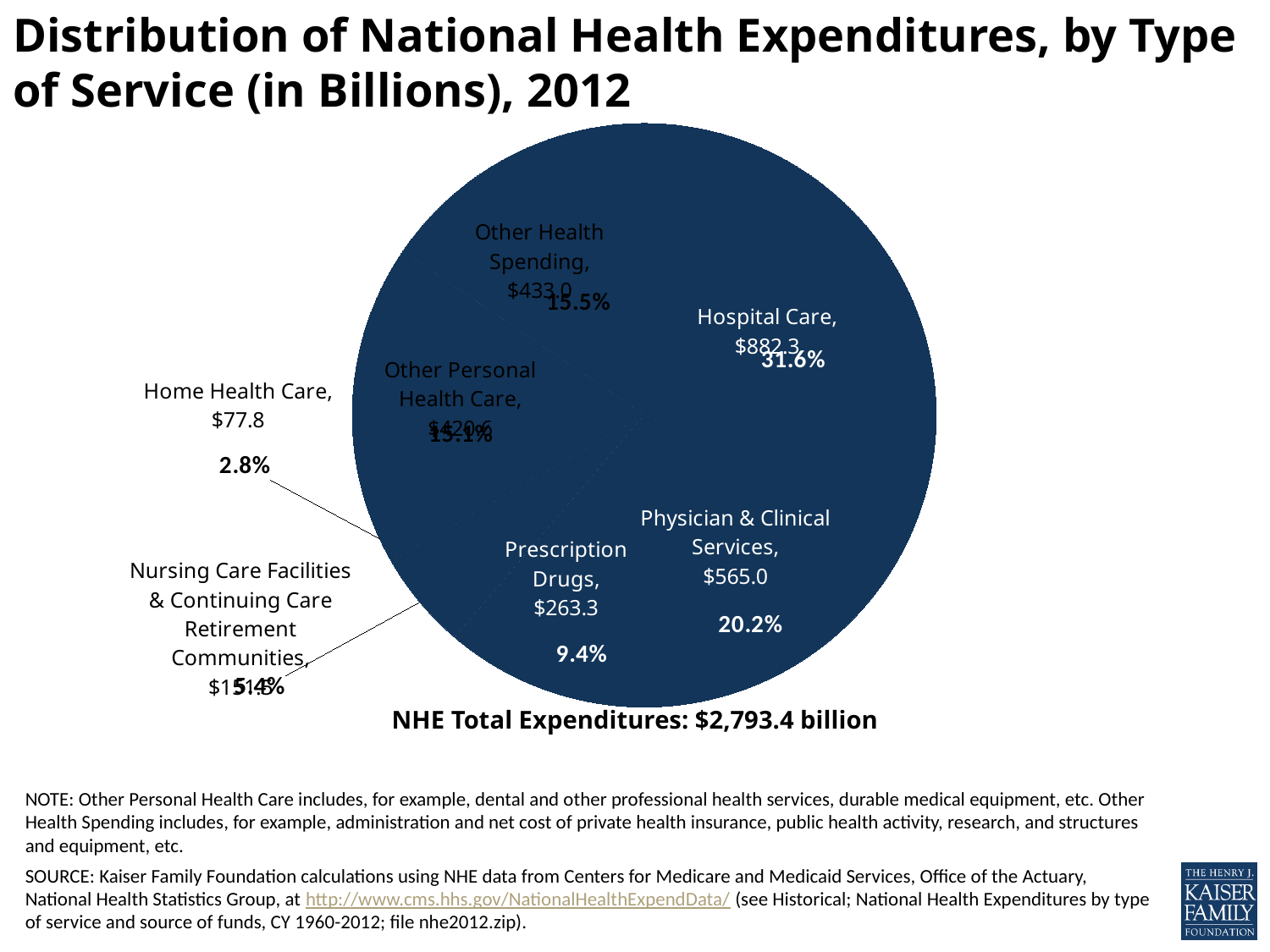
What is the value for Home Health Care? $77.8 Which type of service has the smallest share of expenditures? Home Health Care What is the difference in billions between Hospital Care and Physician & Clinical Services? $317.3 What share of national health expenditures does Hospital Care represent? 31.6% How many types of service are shown in the pie chart? 7 What is the NHE total expenditure stated below the chart? $2,793.4 billion What is the value for Physician & Clinical Services? $565.0 What percentage of the pie is Prescription Drugs? 9.4% What type of chart is shown on the slide? pie chart Which type of service has the largest share of expenditures? Hospital Care What is the value for Hospital Care? $882.3 Which is larger, Prescription Drugs or Physician & Clinical Services? Physician & Clinical Services